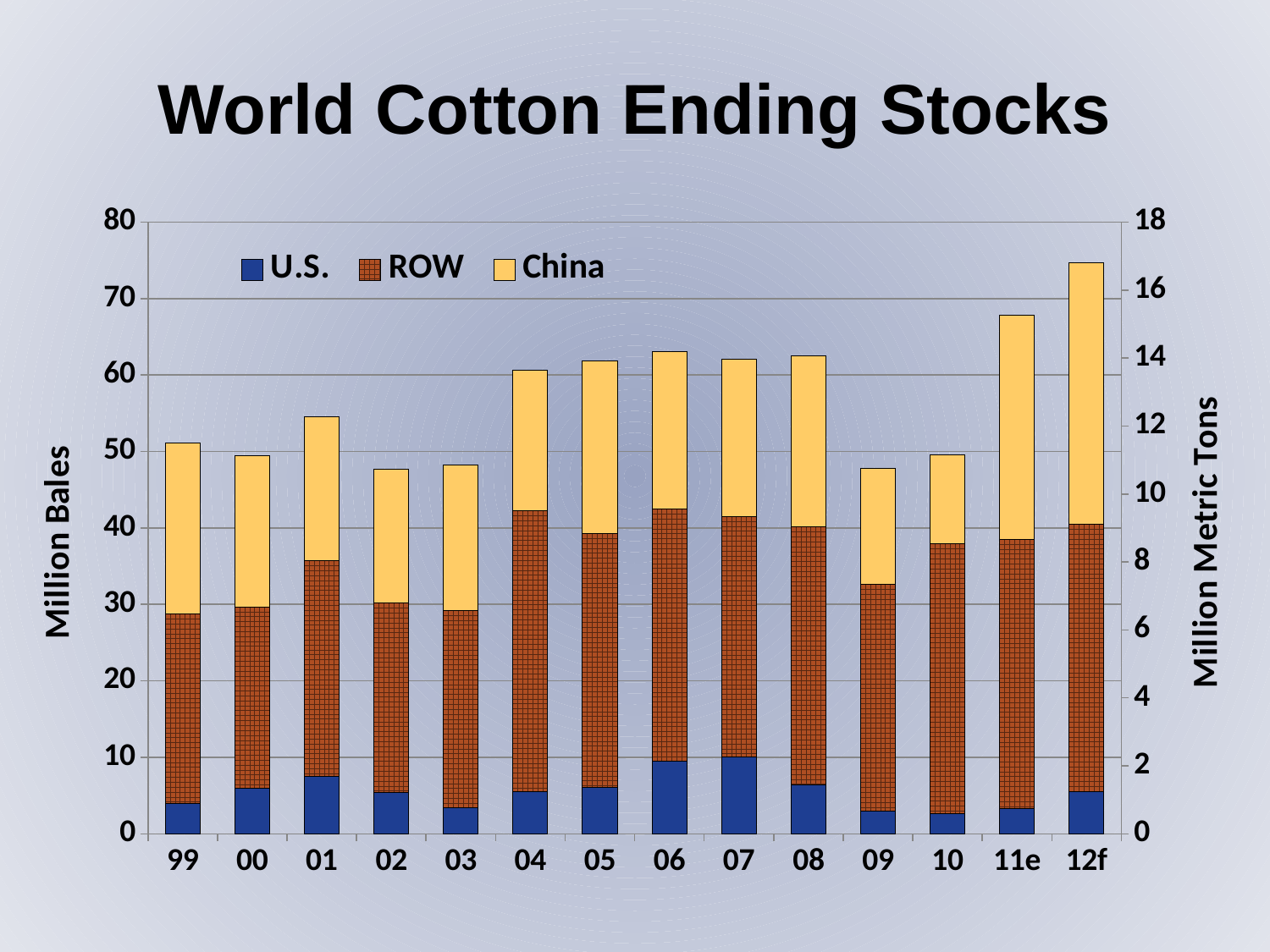
Is the total ending stocks for 12f greater or less than 70 million bales? greater What type of chart is shown on the slide? Stacked bar chart Do total ending stocks rise or fall from 09 to 12f? rise How many years (categories) are shown on the x axis? 14 Which year has the highest total ending stocks? 12f Which year has larger total ending stocks, 03 or 04? 04 What is the title of the chart? World Cotton Ending Stocks Which year has a larger U.S. segment, 07 or 09? 07 Is the total ending stocks for 02 greater or less than 50 million bales? less Which year has larger total ending stocks, 11e or 12f? 12f Is the total ending stocks for 11e greater or less than 60 million bales? greater How many series does the legend list? 3